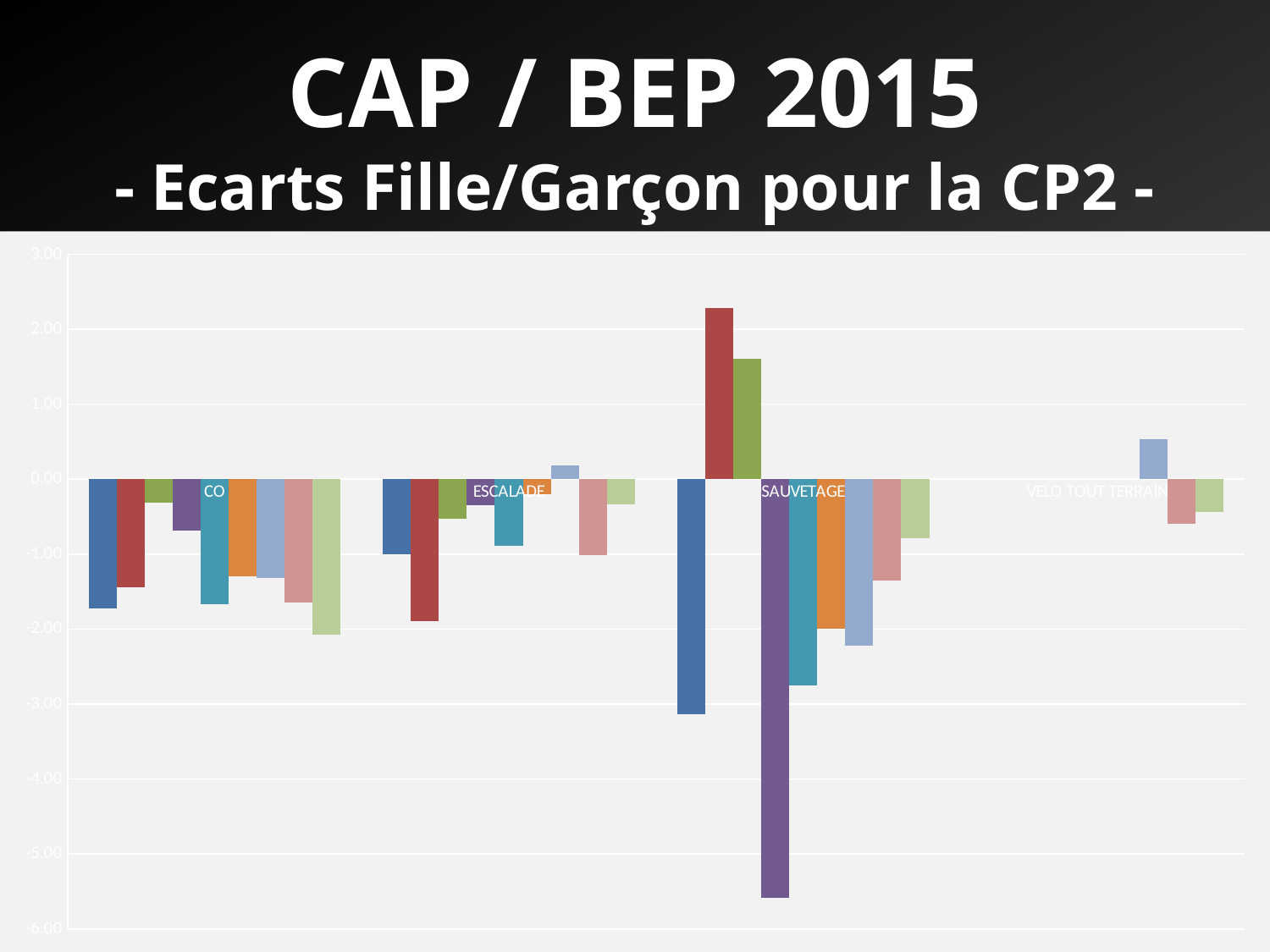
What is the lowest value shown on the vertical axis of the chart? -6.00 How many categories are shown on the x axis of the chart? 4 Which category contains the lowest bar in the chart? SAUVETAGE Is the value of the dark blue bar for CO greater or less than -1.00? less Which category contains the highest bar in the chart? SAUVETAGE What is the subtitle of the chart slide? - Ecarts Fille/Garçon pour la CP2 - Is the value of the purple bar for SAUVETAGE greater or less than -5.00? less Is the value of the red bar for SAUVETAGE greater or less than 2.00? greater How many bars are plotted for the VELO TOUT TERRAIN category? 3 What kind of chart is shown on the slide? bar chart